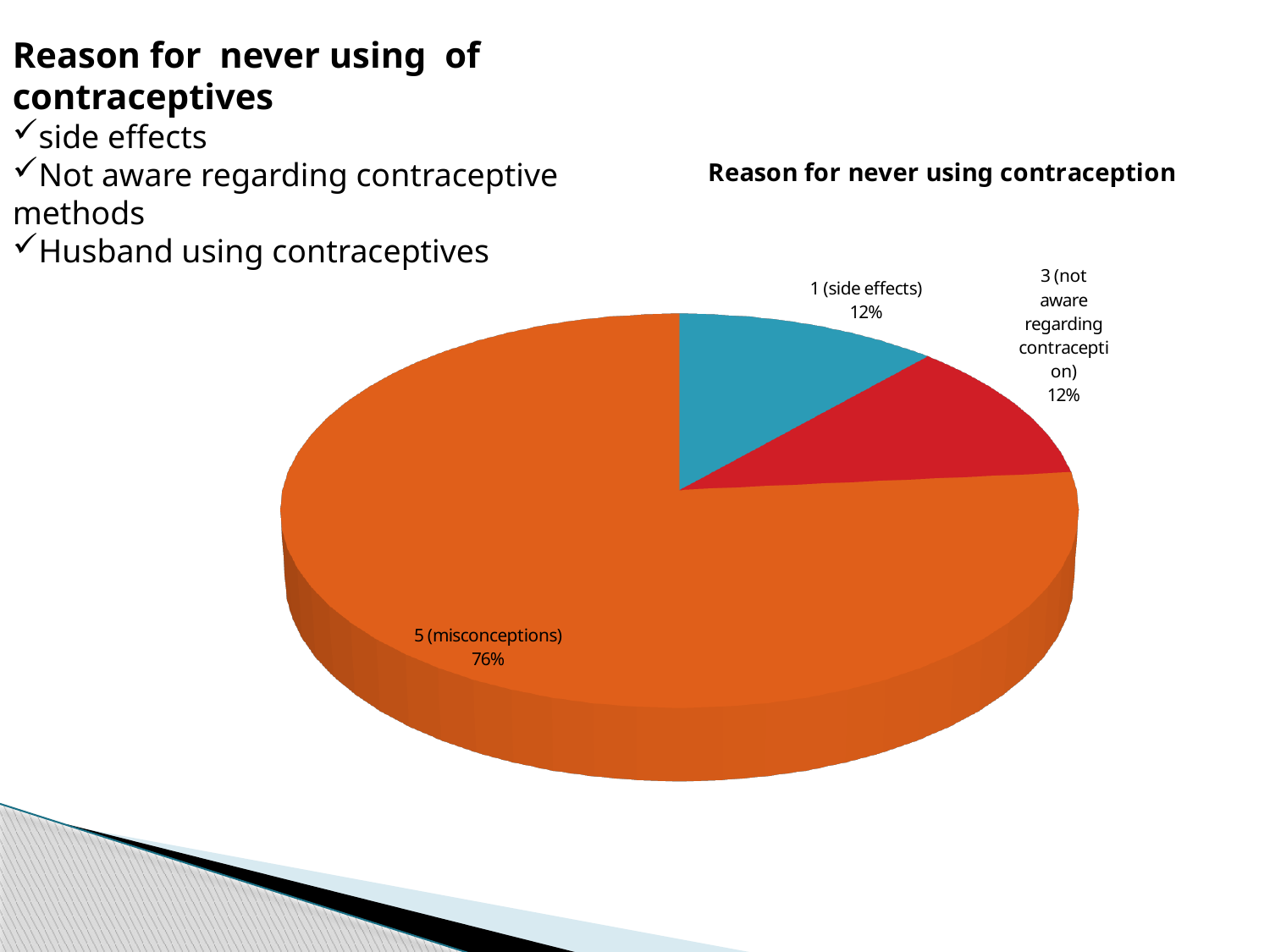
What share of the pie is labelled "5 (misconceptions)"? 76% Which slice of the pie chart is the largest? 5 (misconceptions) What kind of chart is shown on the slide? pie chart What is the title of the chart? Reason for never using contraception What share of the pie is labelled "3 (not aware regarding contraception)"? 12% Which is larger, the "5 (misconceptions)" slice or the "3 (not aware regarding contraception)" slice? 5 (misconceptions) What share of the pie is labelled "1 (side effects)"? 12% How many slices does the pie chart have? 3 What is the difference in percentage points between the "5 (misconceptions)" slice and the "1 (side effects)" slice? 64 What colour is the "5 (misconceptions)" slice? orange Is the share for "5 (misconceptions)" greater or less than 50%? greater What is the combined share of the "1 (side effects)" and "3 (not aware regarding contraception)" slices? 24%